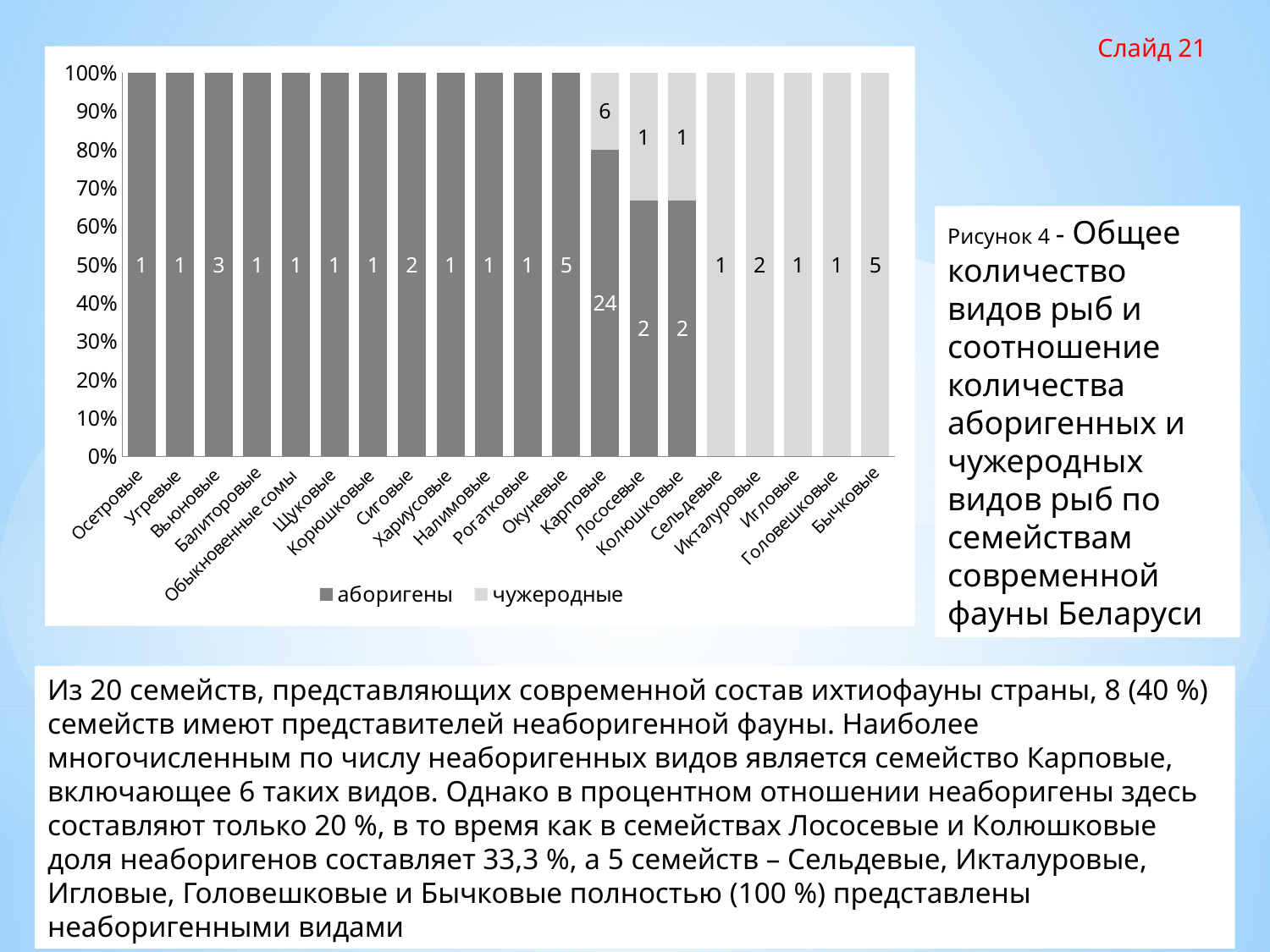
Which family has the highest number of аборигены species? Карповые How many series does the legend list? 2 Which family has the highest number of чужеродные species? Карповые What kind of chart is shown on the slide? bar chart What is the number of чужеродные species for Бычковые? 5 What is the number of аборигены species for Вьюновые? 3 What is the total number of species (аборигены plus чужеродные) for Карповые? 30 Which series is shown in dark grey in the legend? аборигены What is the difference between the number of аборигены species for Окуневые and for Сиговые? 3 How many fish families (categories) are shown on the x axis? 20 What is the number of аборигены species for Карповые? 24 What is the number of чужеродные species for Карповые? 6